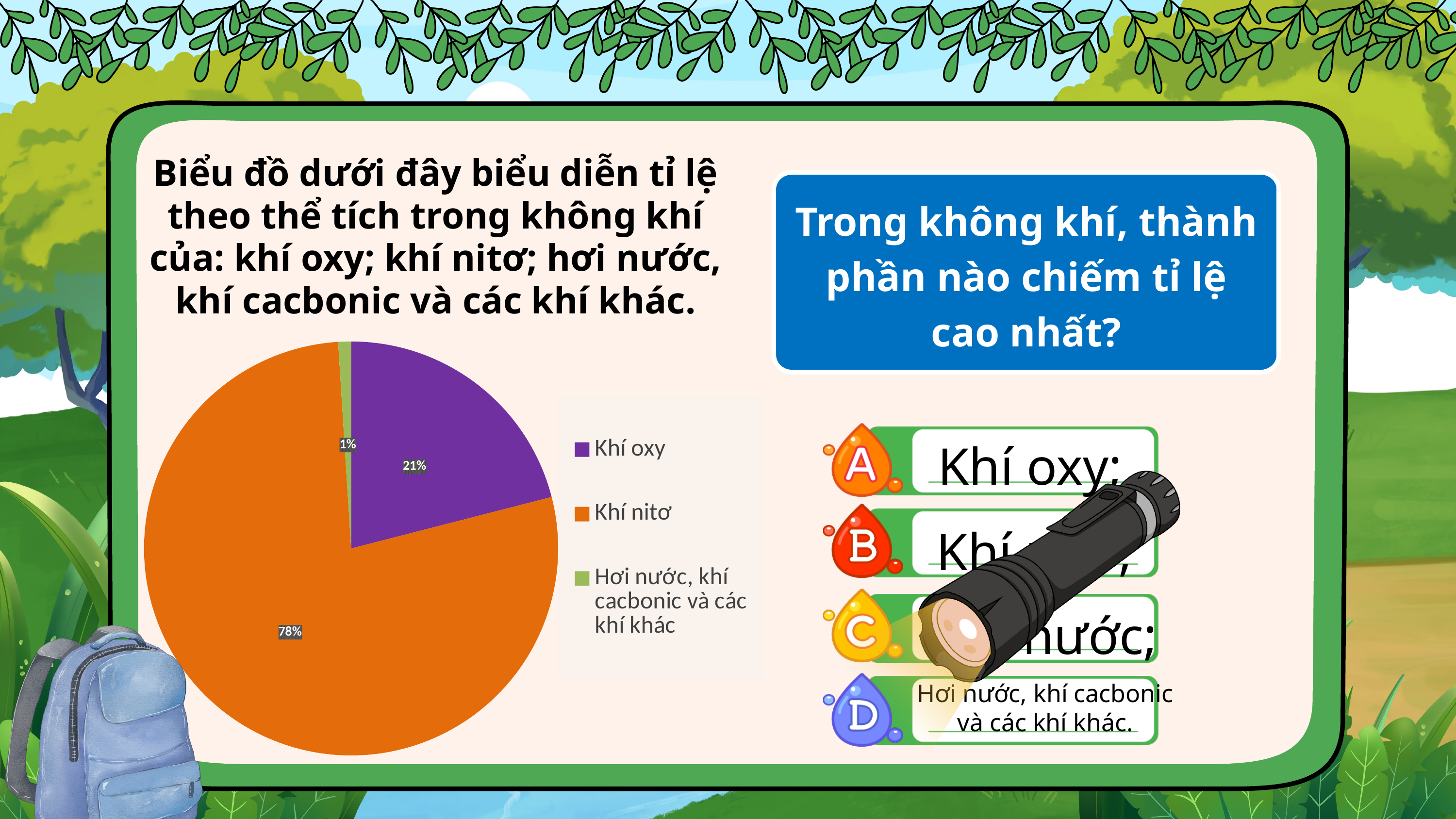
What percentage of the pie chart is Khí nitơ? 78% Which is larger in the pie chart, Khí oxy or Hơi nước, khí cacbonic và các khí khác? Khí oxy What kind of chart is shown on the slide? pie chart What percentage of the pie chart is Khí oxy? 21% How many entries does the legend of the pie chart list? 3 Which slice of the pie chart is the largest? Khí nitơ What colour is the Khí nitơ slice in the pie chart? orange What is the difference in percentage points between Khí nitơ and Khí oxy in the pie chart? 57 What colour is the Khí oxy slice in the pie chart? purple What percentage of the pie chart is Hơi nước, khí cacbonic và các khí khác? 1% Which slice of the pie chart is the smallest? Hơi nước, khí cacbonic và các khí khác How many slices does the pie chart have? 3